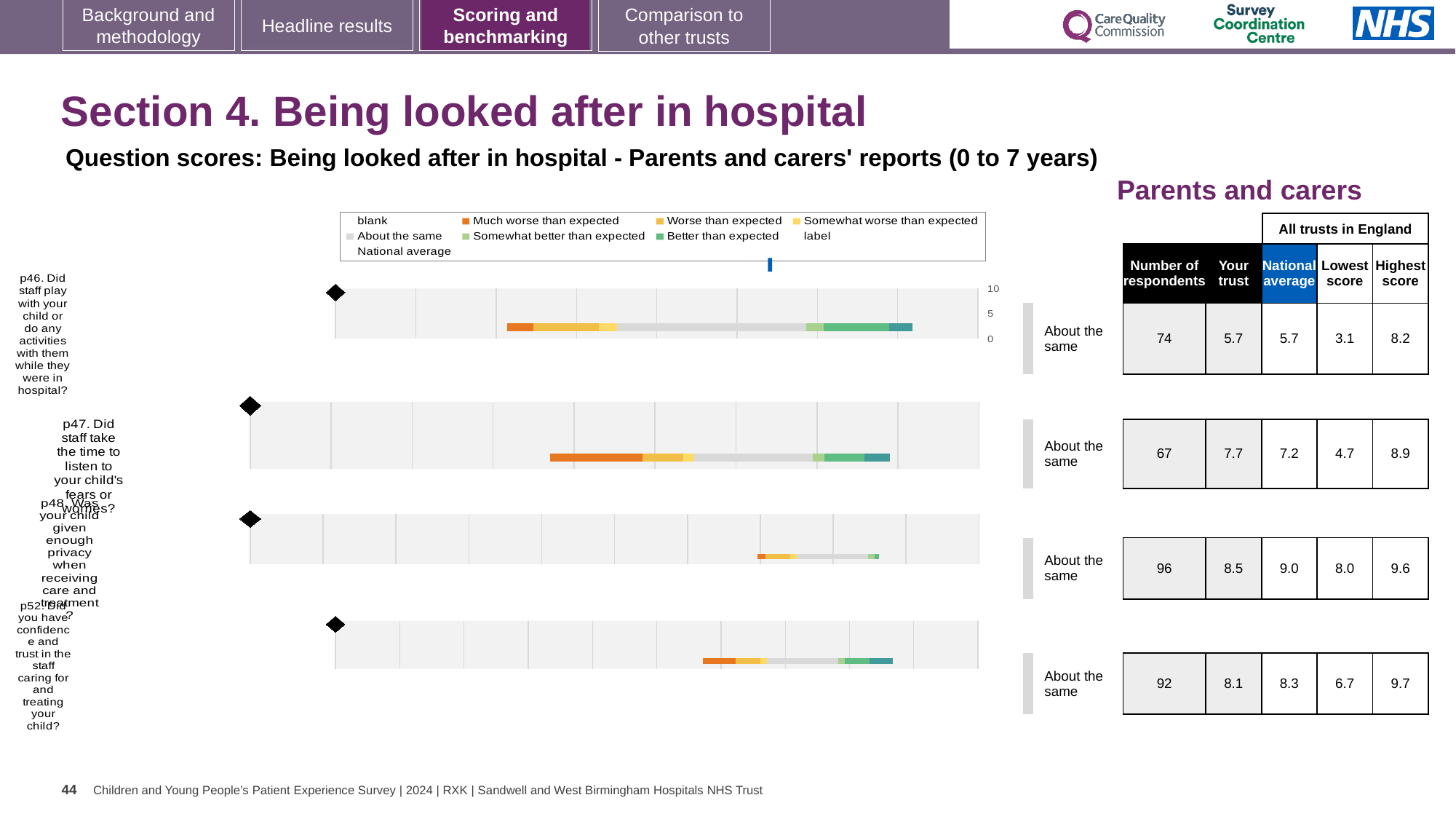
Which question has the highest 'Your trust' score? p48 What is the national average score for p48 (Was your child given enough privacy when receiving care and treatment?)? 9.0 How many respondents answered p46 (Did staff play with your child or do any activities with them while they were in hospital?)? 74 What benchmark rating is shown for each of the four questions on this slide? About the same For p47, what is the difference between the 'Your trust' score and the national average? 0.5 What kind of chart is used to show the question scores on this slide? Bar chart Which legend entry is shown in orange? Much worse than expected How many survey questions are plotted in the chart? 4 What is the 'Your trust' score for p47 (Did staff take the time to listen to your child's fears or worries?)? 7.7 What is the highest score among all trusts in England for p52 (Did you have confidence and trust in the staff caring for and treating your child?)? 9.7 Which question has the lowest 'Your trust' score? p46 For p52, which is larger: the 'Your trust' score or the national average? National average